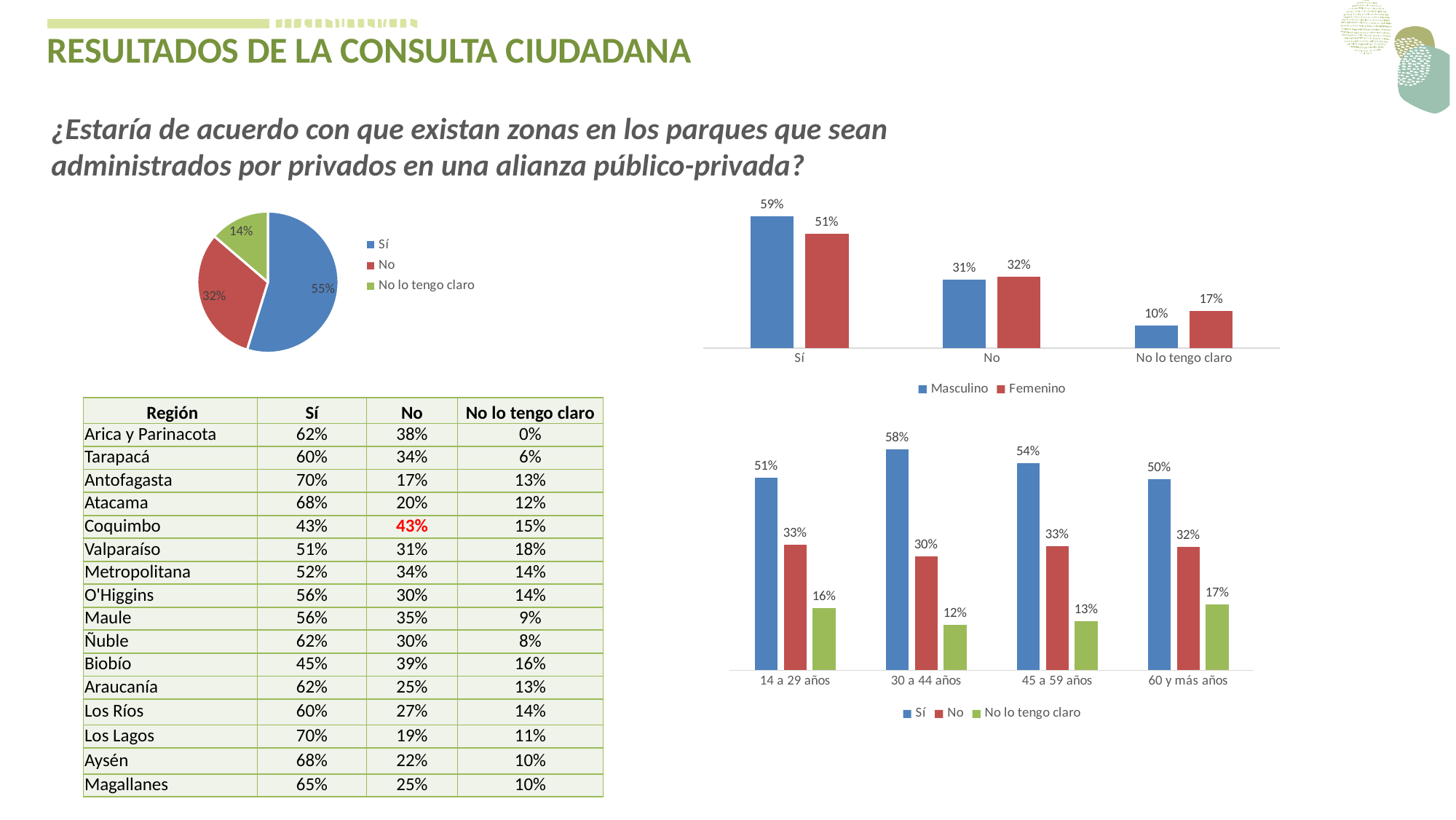
In the pie chart on the left, how many slices are there? 3 In the bottom-right bar chart by age group, what is the "No" value for 30 a 44 años? 30% In the top-right bar chart by gender, how many series does the legend list? 2 In the top-right bar chart by gender, what is the value for Masculino in the "Sí" category? 59% In the top-right bar chart by gender, what is the value for Femenino in the "No lo tengo claro" category? 17% In the bottom-right bar chart by age group, is the "Sí" value for 14 a 29 años larger or the "Sí" value for 60 y más años? 14 a 29 años What type of chart is the bottom-right chart by age group? Bar chart In the bottom-right bar chart by age group, which age group has the lowest "No lo tengo claro" value? 30 a 44 años In the bottom-right bar chart by age group, which age group has the highest "Sí" value? 30 a 44 años In the top-right bar chart by gender, what is the difference between Masculino and Femenino in the "Sí" category? 8% In the pie chart on the left, what share of respondents answered "Sí"? 55% In the pie chart on the left, what share of respondents answered "No lo tengo claro"? 14%